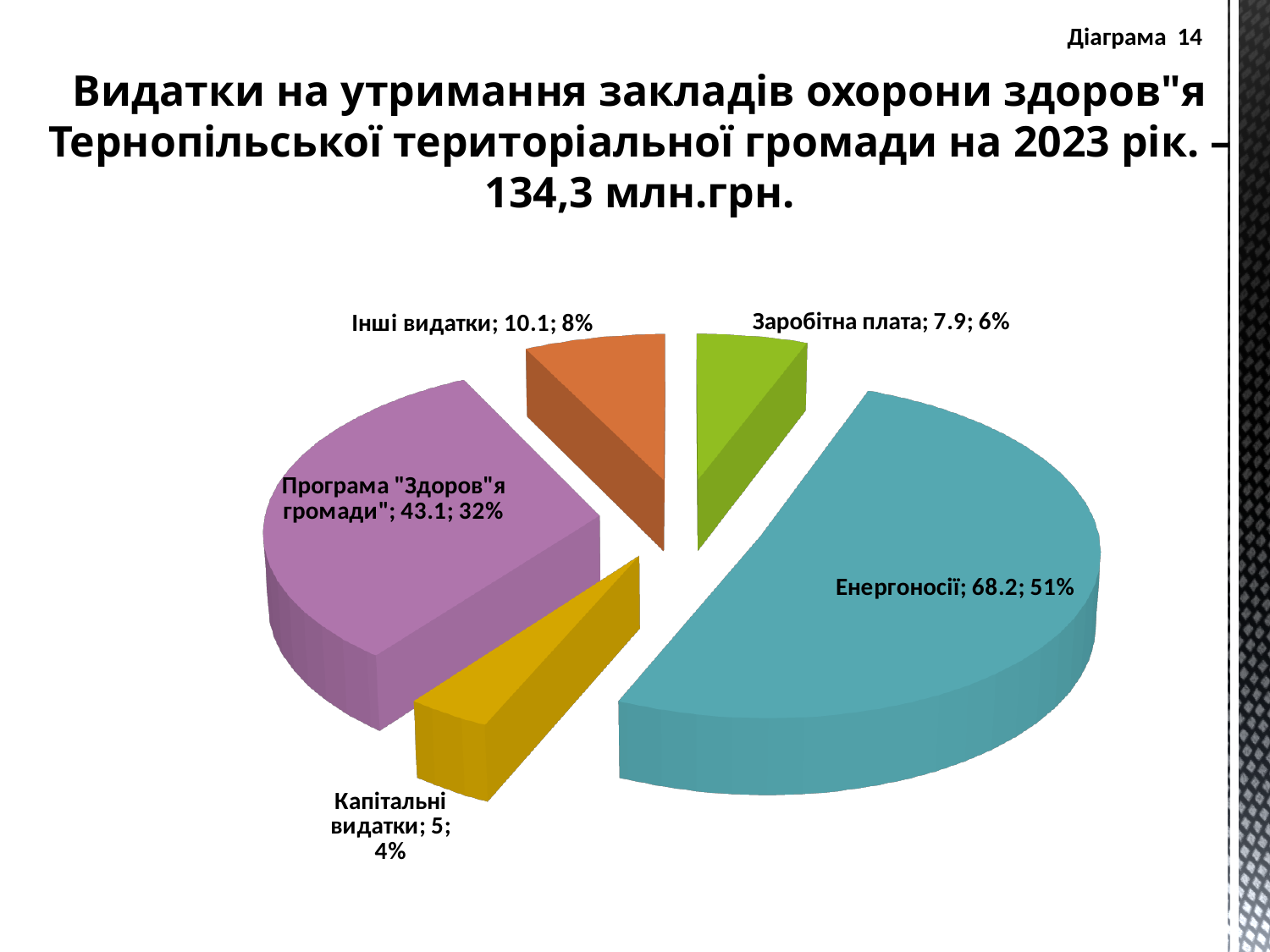
What share of the pie does Енергоносії represent? 51% What is the value for Енергоносії? 68.2 Which category has the largest slice? Енергоносії What is the value for Заробітна плата? 7.9 What is the value for Капітальні видатки? 5 Which category has the smallest slice? Капітальні видатки What is the difference between the values for Енергоносії and Програма "Здоров"я громади"? 25.1 What kind of chart is shown on the slide? Pie chart How many slices does the pie chart have? 5 What share of the pie does Інші видатки represent? 8% What is the value for Програма "Здоров"я громади"? 43.1 Which is larger, the value for Інші видатки or the value for Заробітна плата? Інші видатки